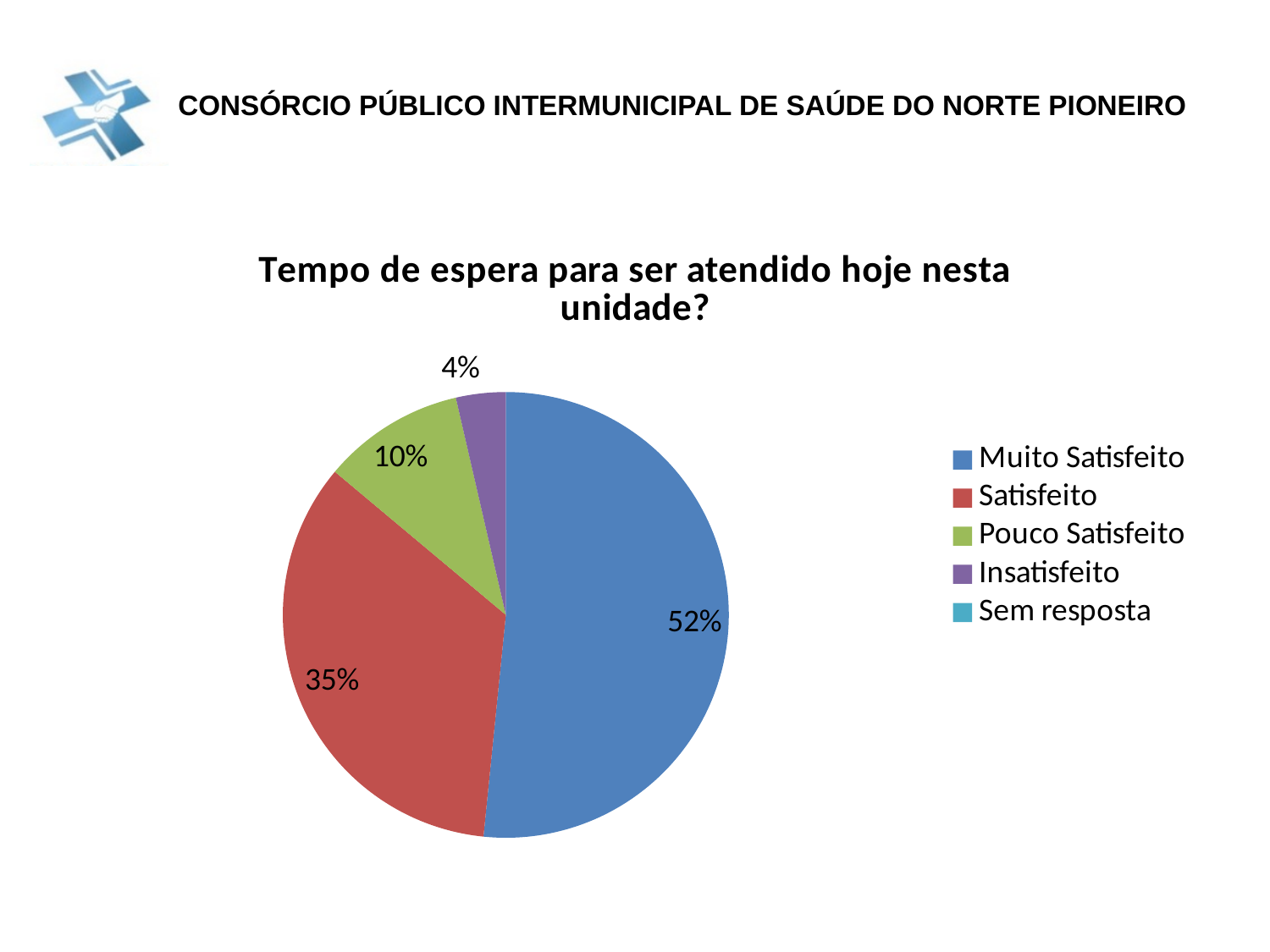
What percentage of the pie is labelled for Insatisfeito? 4% Which is larger, the Satisfeito slice or the Pouco Satisfeito slice? Satisfeito How many entries does the legend list? 5 What percentage of the pie is labelled for Muito Satisfeito? 52% What is the difference in percentage points between Muito Satisfeito and Satisfeito? 17 What percentage of the pie is labelled for Satisfeito? 35% Which category has the largest slice of the pie? Muito Satisfeito What is the title of the chart? Tempo de espera para ser atendido hoje nesta unidade? Which labelled slice is the smallest in the pie? Insatisfeito What type of chart is shown on the slide? pie chart What colour is the Satisfeito slice? red What percentage of the pie is labelled for Pouco Satisfeito? 10%